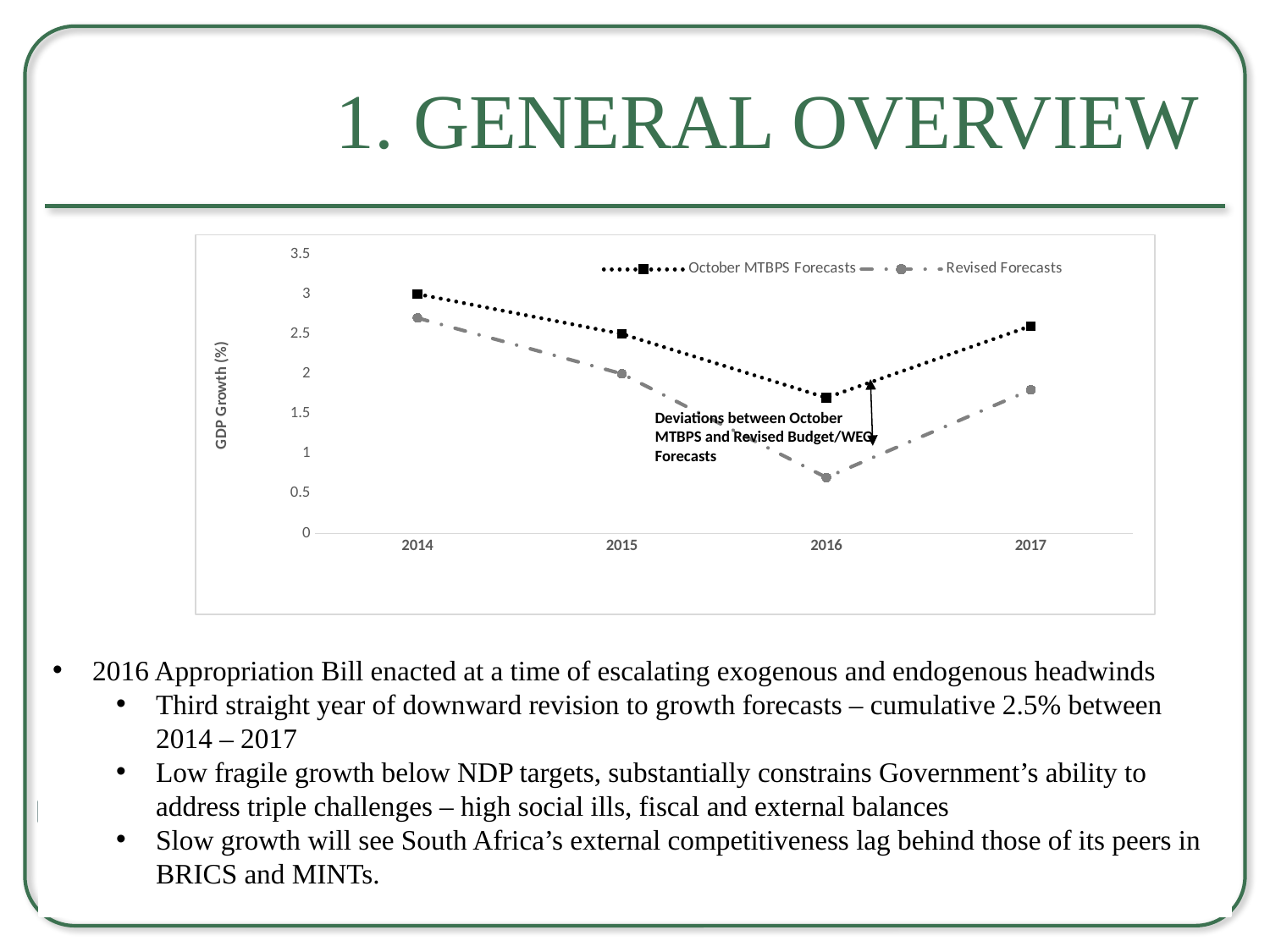
What are the two series named in the chart legend? October MTBPS Forecasts and Revised Forecasts How many years are shown on the x axis of the chart? 4 In which year is the October MTBPS Forecasts value lowest? 2016 What kind of chart is shown on the slide? line chart Do the Revised Forecasts values rise or fall from 2014 to 2016? fall What is the label of the vertical axis of the chart? GDP Growth (%) In which year is the Revised Forecasts value lowest? 2016 How many series does the chart legend list? 2 In which year is the October MTBPS Forecasts value highest? 2014 Is the Revised Forecasts value for 2016 greater or less than 1? less In which year is the Revised Forecasts value highest? 2014 In 2016, which series has the higher value, October MTBPS Forecasts or Revised Forecasts? October MTBPS Forecasts